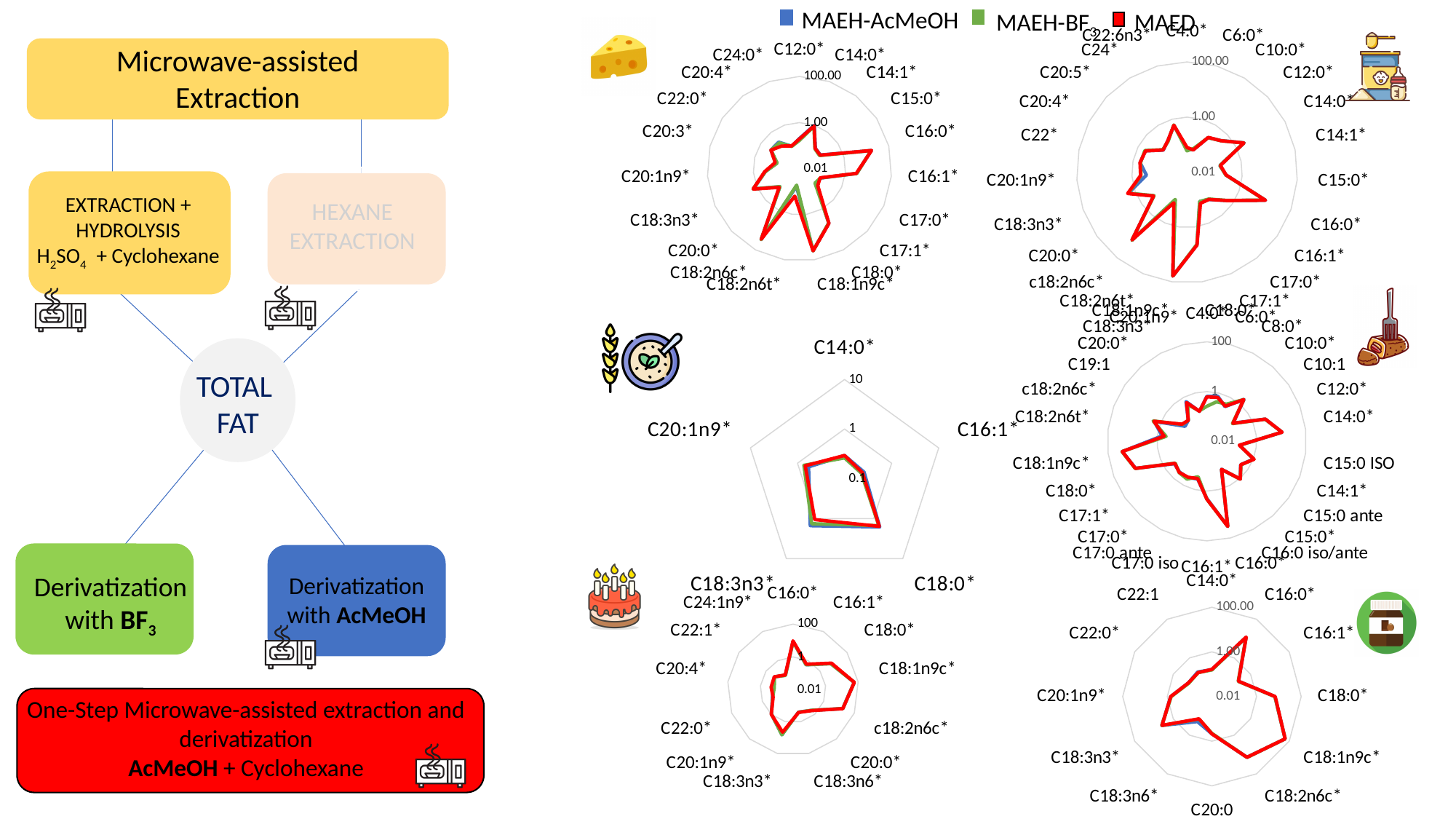
Which series is shown in blue in the legend? MAEH-AcMeOH In the pentagon-shaped radar chart next to the cereal bowl icon, is the value for C16:1* greater or less than 1? less Which series is shown in red in the legend? MAED In the radar chart next to the cake icon (bottom left), is the value for C16:0* greater or less than 1? greater What kind of chart is used for the fatty acid profiles on the right side of the slide? radar chart In the radar chart next to the chocolate spread jar icon (bottom right), is the value for C18:1n9c* greater or less than 1.00? greater In the pentagon-shaped radar chart next to the cereal bowl icon, how many categories are plotted? 5 How many series does the legend at the top of the slide list? 3 In the pentagon-shaped radar chart next to the cereal bowl icon, what is the outermost axis tick value? 10 In the radar chart next to the cheese icon (top left), what is the outermost axis tick value? 100.00